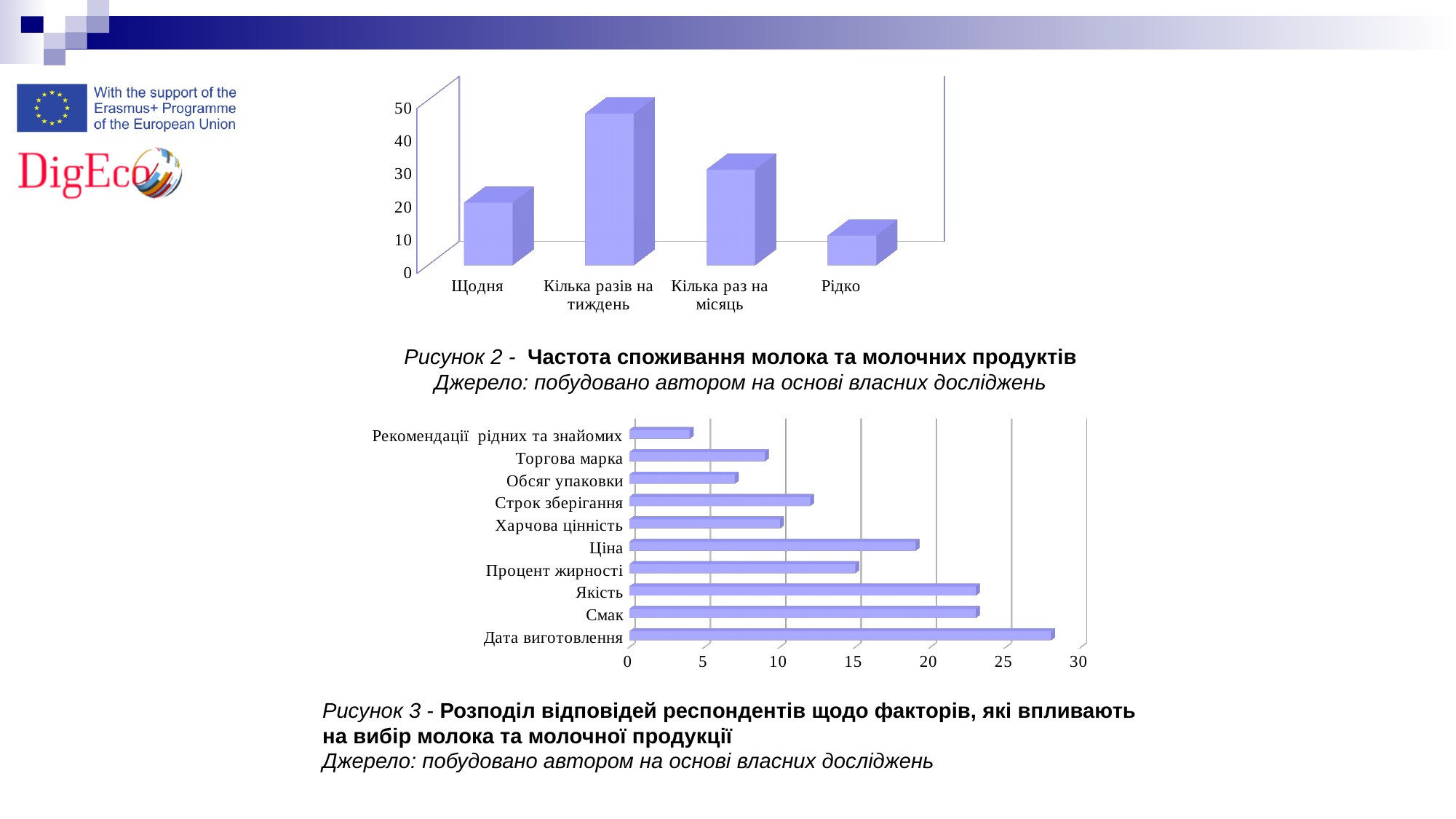
In the bottom chart (Рисунок 3), which is larger: the value for Ціна or the value for Процент жирності? Ціна In the top chart (Рисунок 2), is the value for Рідко greater or less than 20? less In the bottom chart (Рисунок 3), is the value for Дата виготовлення greater or less than 25? greater In the top chart (Рисунок 2), is the value for Кілька разів на тиждень greater or less than 40? greater In the top chart (Рисунок 2), which category has the lowest value? Рідко What type of chart is the bottom chart (Рисунок 3)? Bar chart In the bottom chart (Рисунок 3), how many factors are listed? 10 In the bottom chart (Рисунок 3), which factor has the highest value? Дата виготовлення In the top chart (Рисунок 2), which is larger: the value for Щодня or the value for Кілька раз на місяць? Кілька раз на місяць In the top chart (Рисунок 2), how many categories are shown on the x axis? 4 In the top chart (Рисунок 2), which category has the highest value? Кілька разів на тиждень In the bottom chart (Рисунок 3), which factor has the lowest value? Рекомендації рідних та знайомих